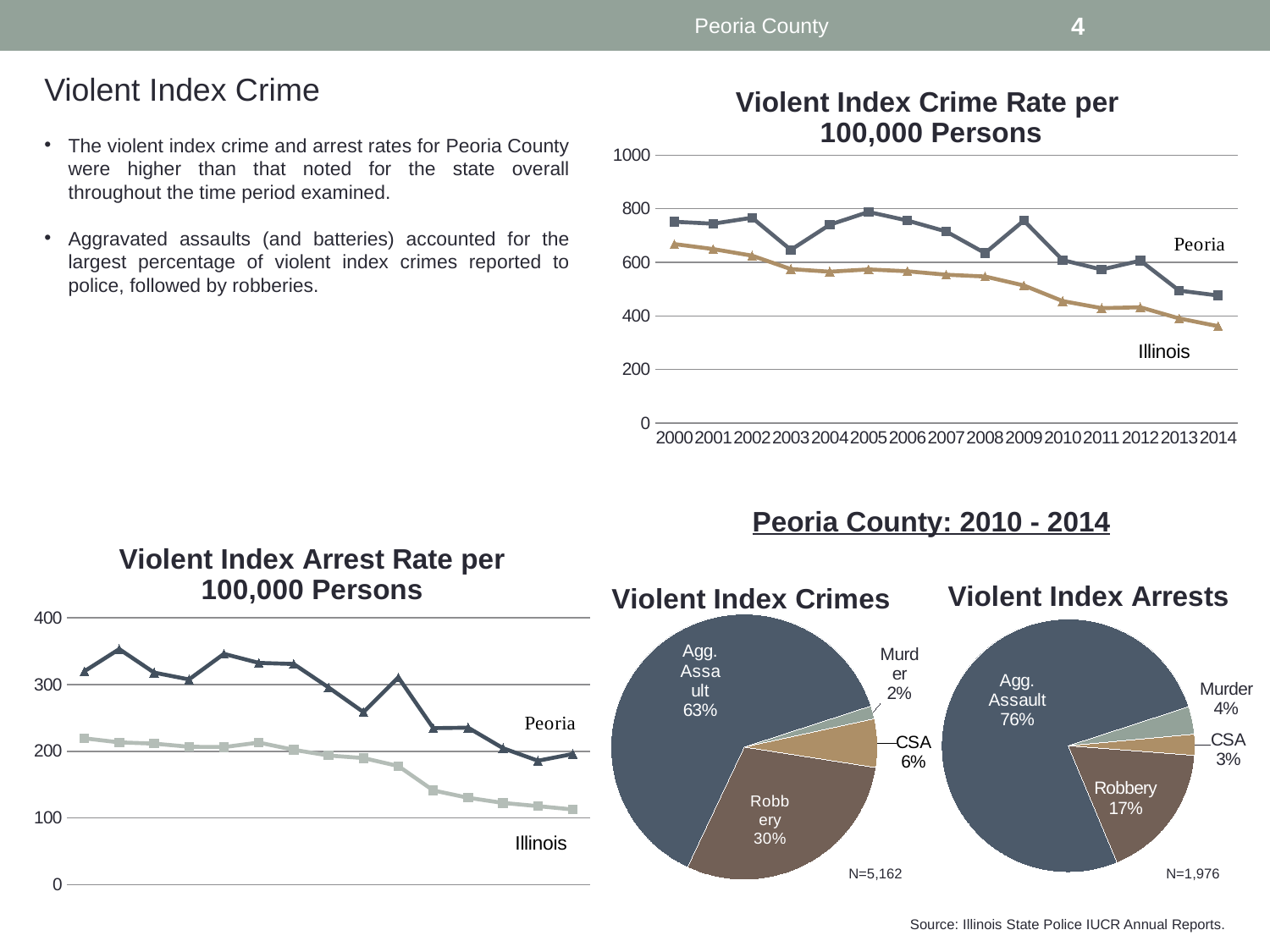
In the Violent Index Arrests pie chart, what percentage is Agg. Assault? 76% What type of chart is the Violent Index Crime Rate per 100,000 Persons chart? Line chart In the Violent Index Crime Rate per 100,000 Persons chart, is the Peoria value for 2005 greater or less than 600? greater In the Violent Index Crime Rate per 100,000 Persons chart, does the Illinois line rise or fall from 2000 to 2014? Fall Is the Murder share larger in the Violent Index Crimes pie chart or the Violent Index Arrests pie chart? Violent Index Arrests How many slices does the Violent Index Crimes pie chart have? 4 In the Violent Index Crimes pie chart, which category has the largest share? Agg. Assault In the Violent Index Arrests pie chart, how many percentage points larger is Agg. Assault than Robbery? 59 percentage points How many series are plotted in the Violent Index Crime Rate per 100,000 Persons chart? 2 In the Violent Index Crimes pie chart, what percentage is Robbery? 30% In the Violent Index Crime Rate per 100,000 Persons chart, is the Illinois value for 2014 greater or less than 400? less In the Violent Index Arrests pie chart, which category has the smallest share? CSA